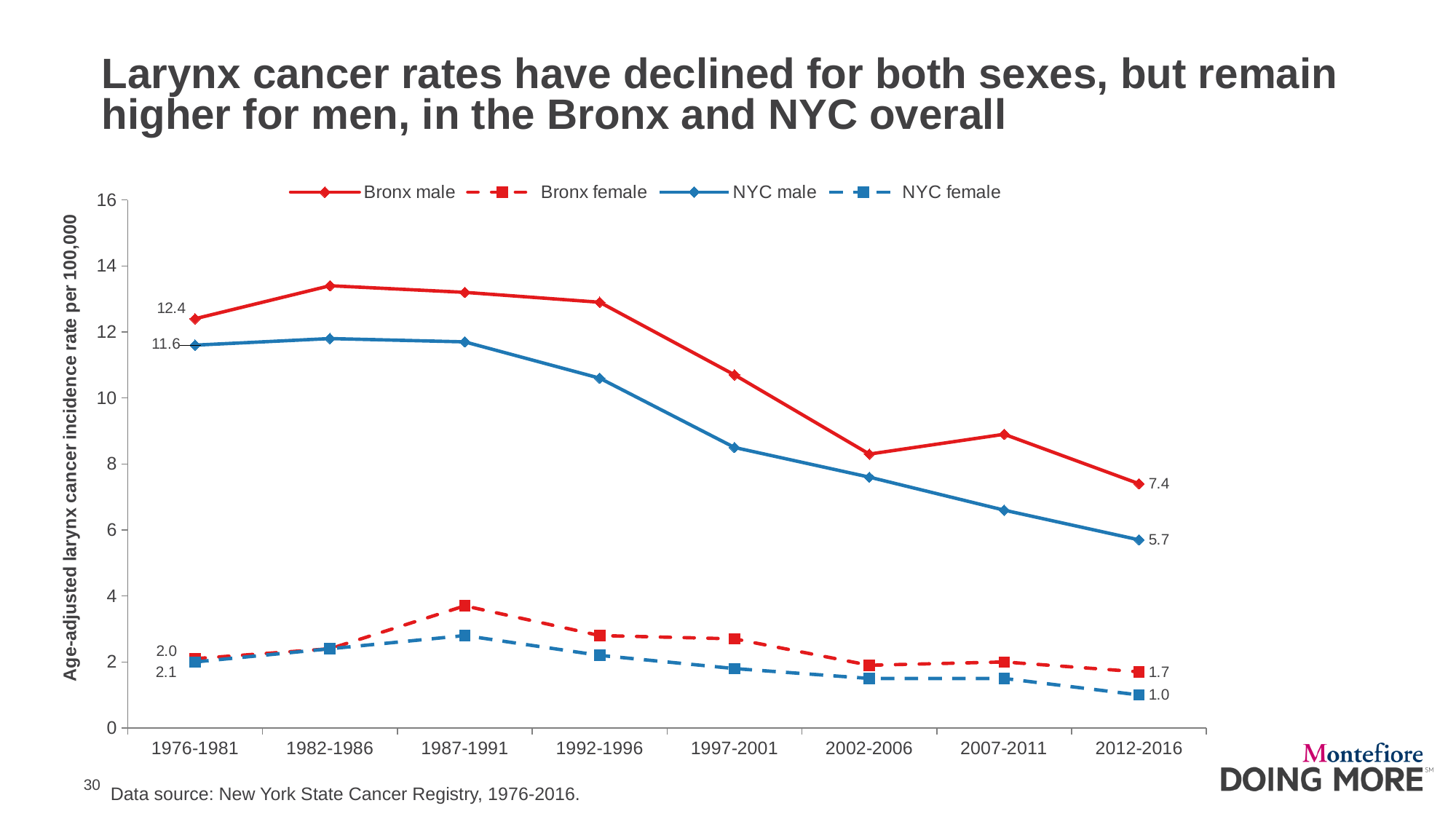
What is the Bronx male larynx cancer incidence rate for 1976-1981? 12.4 By how much did the Bronx male rate fall from 1976-1981 to 2012-2016? 5.0 What is the Bronx male larynx cancer incidence rate for 2012-2016? 7.4 How many time periods are shown on the x axis? 8 Which series has the highest value in 1982-1986? Bronx male What is the NYC male larynx cancer incidence rate for 1976-1981? 11.6 What kind of chart is shown on the slide? line chart How many series does the legend list? 4 Is the Bronx male value for 1982-1986 greater or less than 12? greater What is the NYC female larynx cancer incidence rate for 2012-2016? 1.0 What is the Bronx female larynx cancer incidence rate for 2012-2016? 1.7 What is the NYC male larynx cancer incidence rate for 2012-2016? 5.7